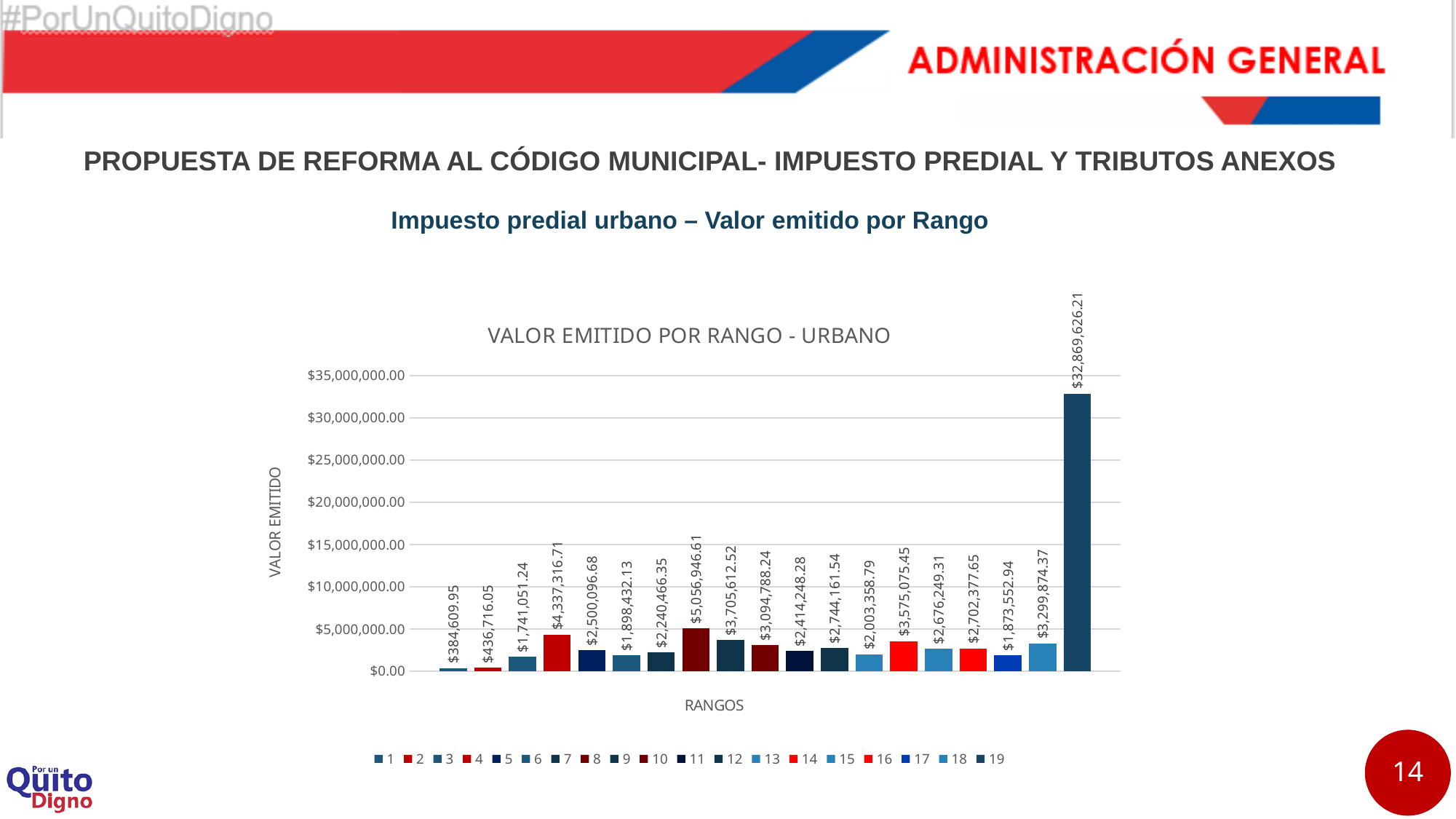
What is the value for range 8 in the chart? $5,056,946.61 What is the value for range 1 in the chart? $384,609.95 What kind of chart is shown on the slide? Bar chart How many ranges (bars) are shown in the chart? 19 Is the value for range 19 greater or less than $30,000,000.00? greater Which range has the highest value emitted? 19 What is the value for range 14 in the chart? $3,575,075.45 Which range has the lowest value emitted? 1 What is the difference between the values for range 4 and range 3? $2,596,265.47 What is the title of the chart? VALOR EMITIDO POR RANGO - URBANO Which has a larger value, range 9 or range 10? Range 9 What is the value for range 19 in the chart? $32,869,626.21